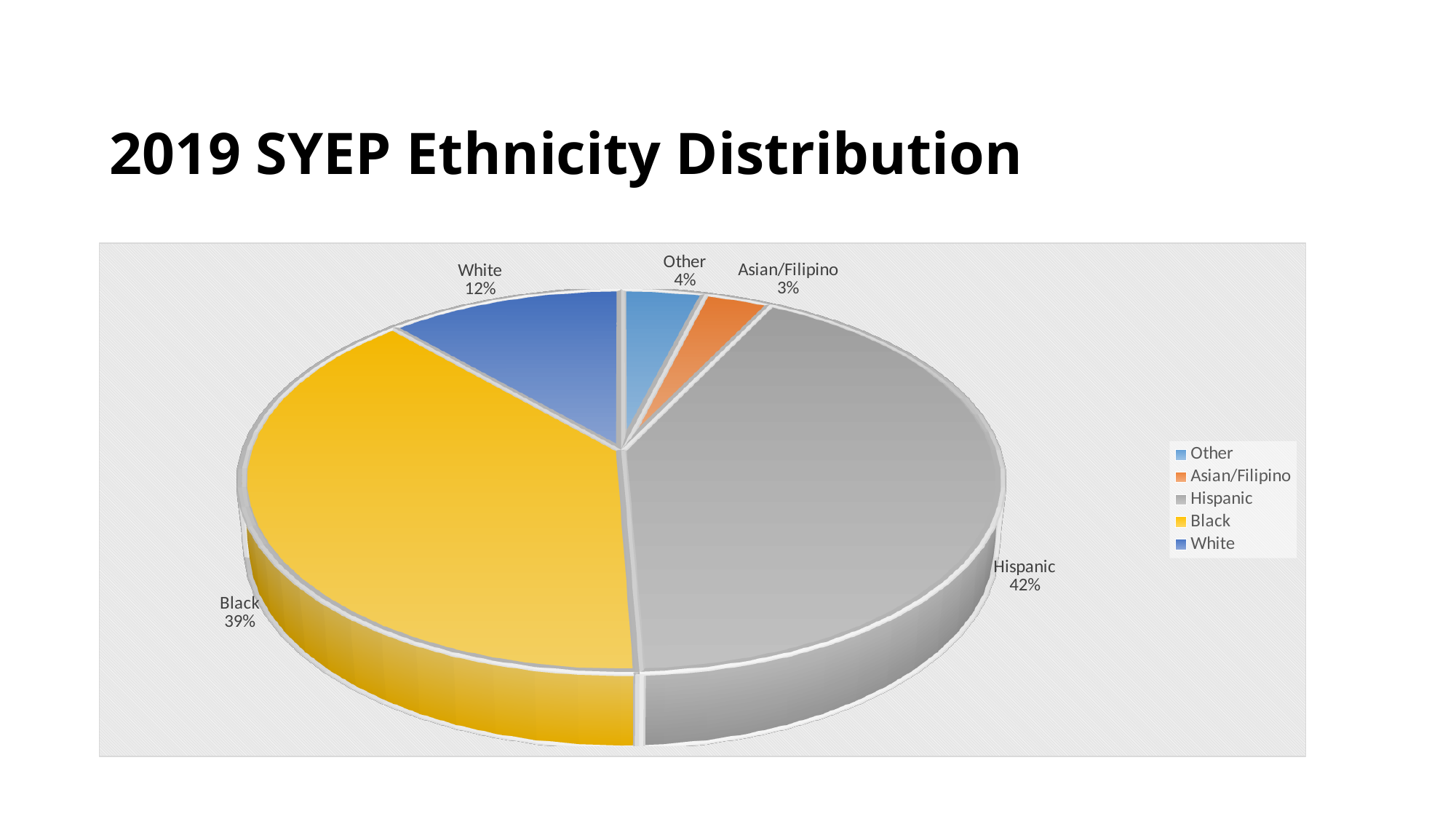
Which category has the largest share of the pie? Hispanic How many categories does the pie chart have? 5 Which is larger, the share for White or the share for Other? White What is the value for White? 12% What kind of chart is shown on the slide? Pie chart Which category has the smallest share of the pie? Asian/Filipino What share of the pie does Black represent? 39% What is the value for Other? 4% What share of the pie does Hispanic represent? 42% What is the difference between the Hispanic and Black shares? 3% What is the title of the slide? 2019 SYEP Ethnicity Distribution What is the value for Asian/Filipino? 3%